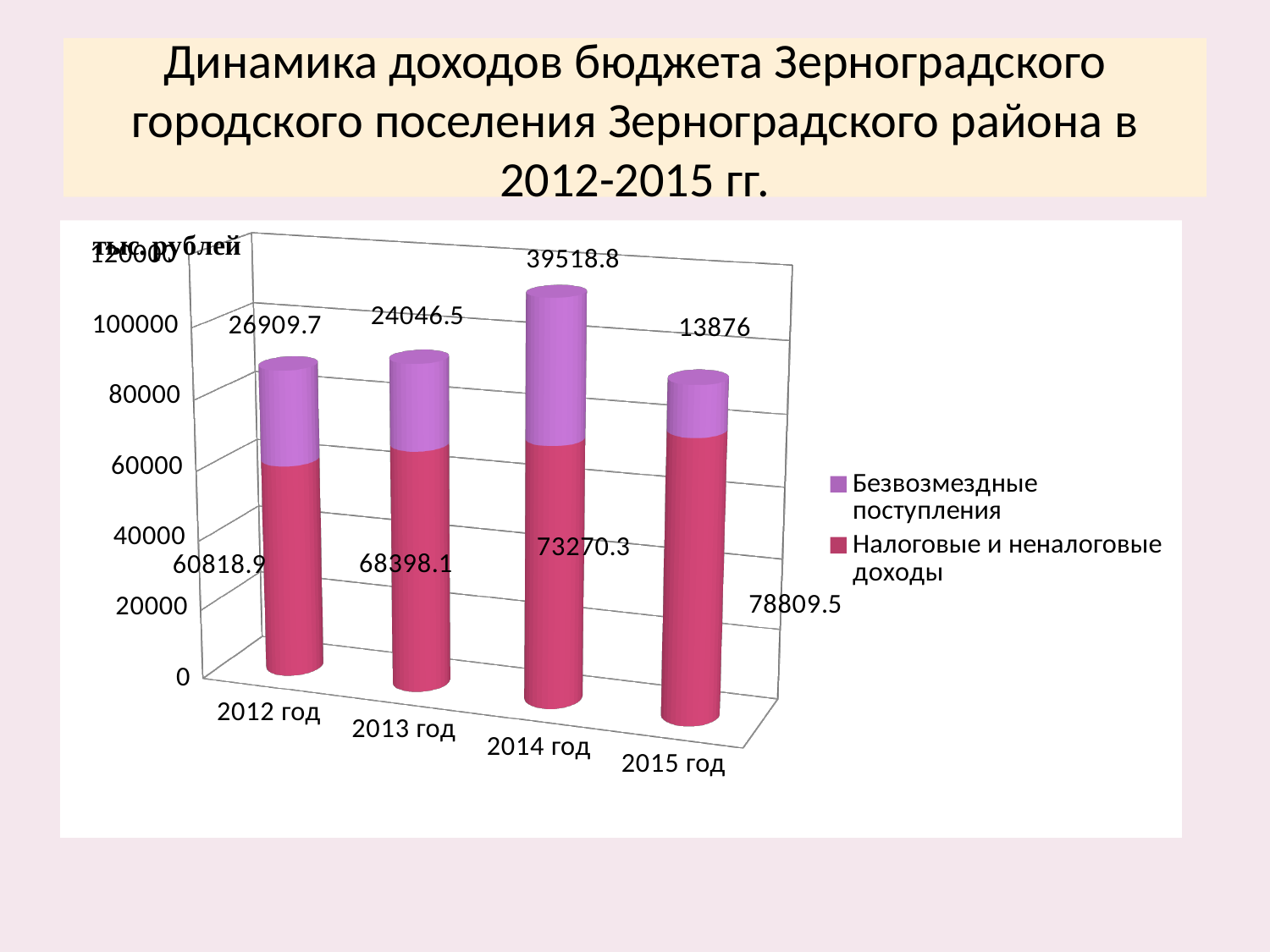
In which year is Налоговые и неналоговые доходы lowest? 2012 год How many series does the legend list? 2 How many years are shown on the x axis? 4 Which is larger: Безвозмездные поступления in 2012 год or in 2013 год? 2012 год What is the difference between Налоговые и неналоговые доходы in 2015 год and 2012 год? 17990.6 In which year is Безвозмездные поступления highest? 2014 год What kind of chart is shown on the slide? Stacked bar chart What is the total of the stacked bar for 2014 год? 112789.1 What is the value of Налоговые и неналоговые доходы for 2012 год? 60818.9 What is the value of Безвозмездные поступления for 2015 год? 13876 Does Налоговые и неналоговые доходы rise or fall from 2012 год to 2015 год? Rise What is the value of Налоговые и неналоговые доходы for 2014 год? 73270.3